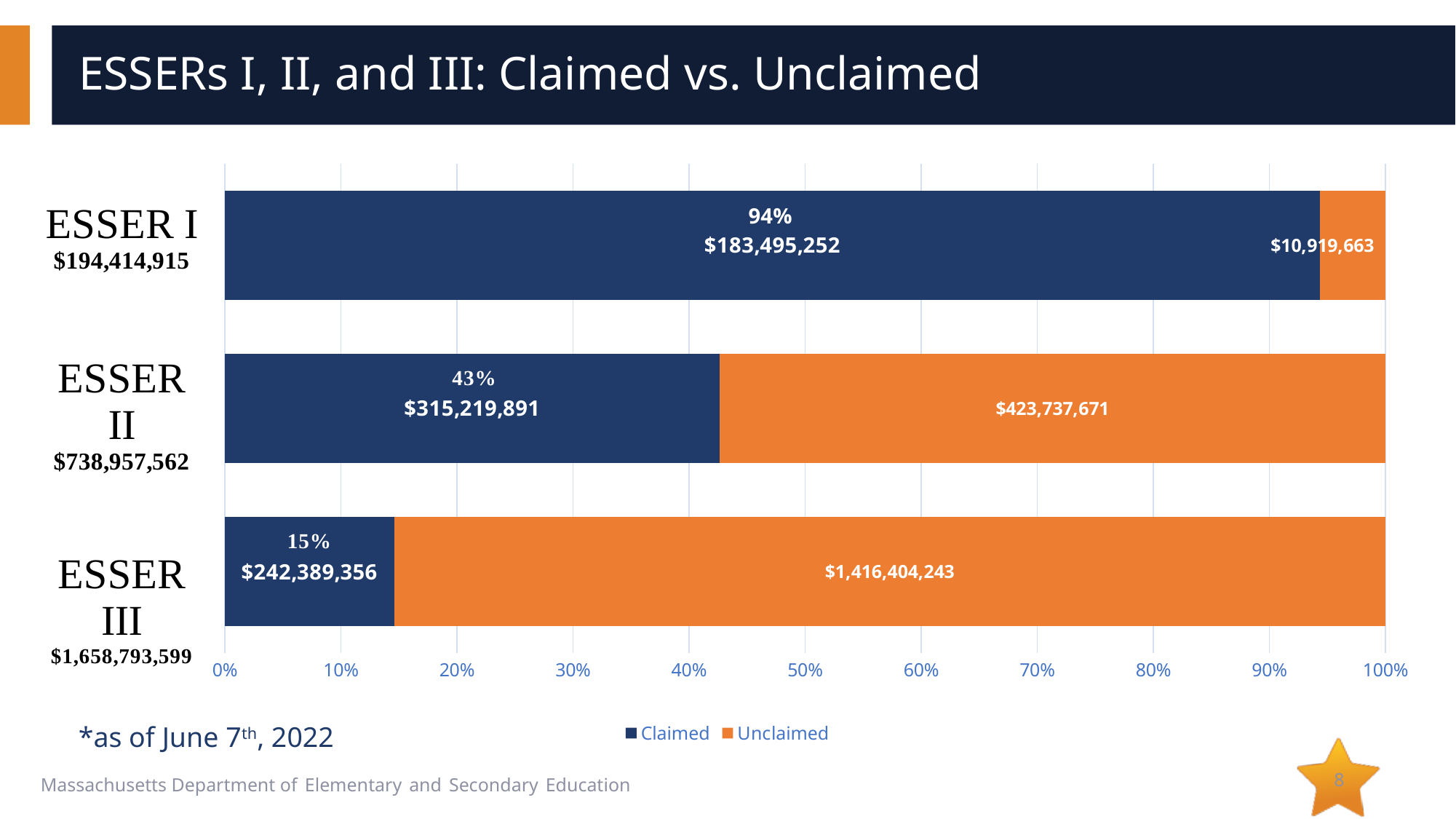
For ESSER II, how much larger is the Unclaimed amount than the Claimed amount? $108,517,780 What is the Unclaimed amount for ESSER II? $423,737,671 What is the total amount for the ESSER III bar? $1,658,793,599 How many series does the legend list? 2 For ESSER I, which is larger, the Claimed amount or the Unclaimed amount? Claimed What percentage of ESSER III has been claimed? 15% Which ESSER fund has the lowest claimed percentage? ESSER III How many ESSER funds are shown on the chart? 3 Which ESSER fund has the highest claimed percentage? ESSER I What is the Unclaimed amount for ESSER III? $1,416,404,243 What is the Claimed amount for ESSER I? $183,495,252 Is the claimed share for ESSER II greater or less than 50%? less